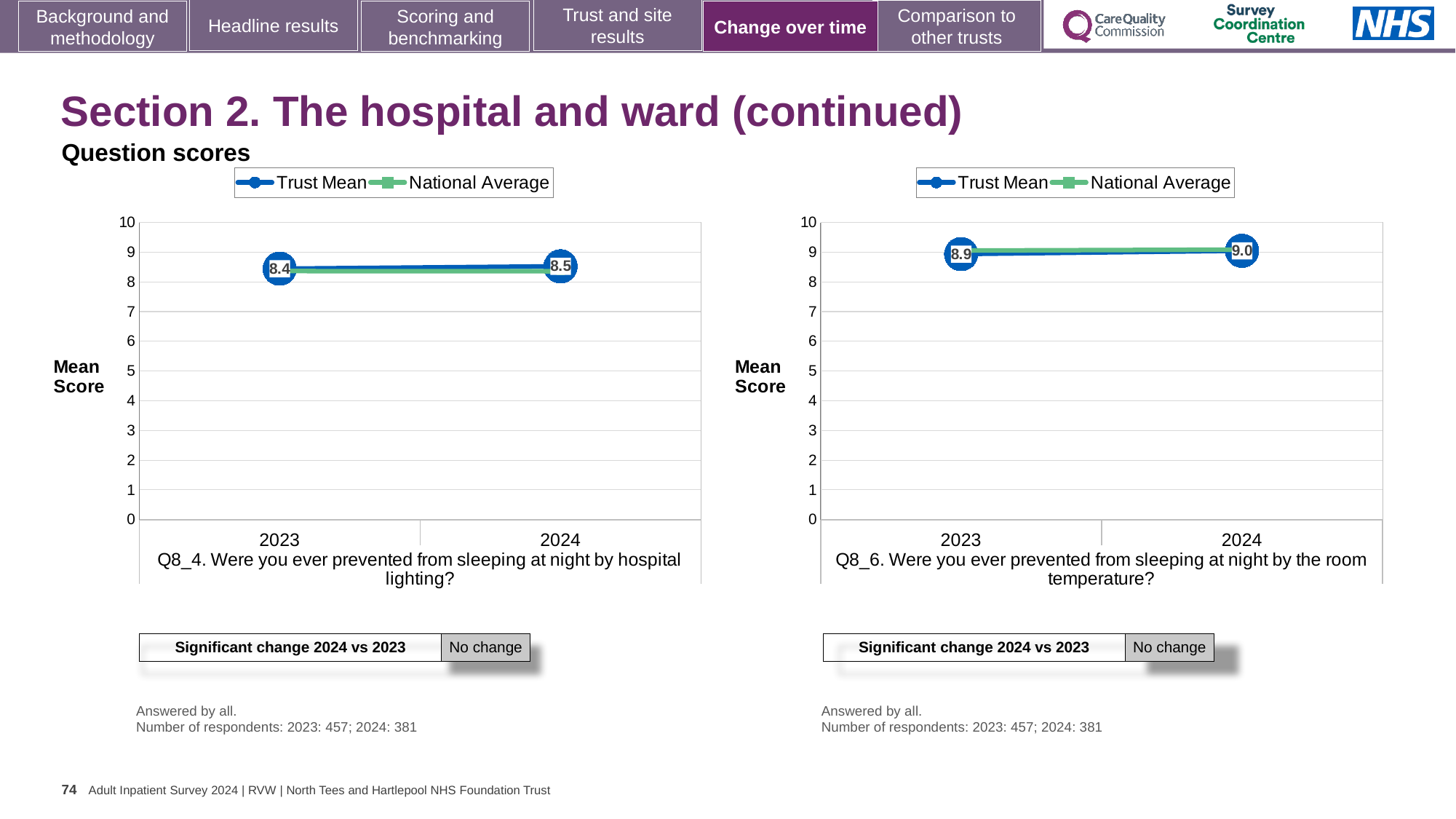
What kind of chart is the left chart (Q8_4, hospital lighting)? line chart On the left chart (Q8_4, hospital lighting), what is the Trust Mean score for 2024? 8.5 On the right chart (Q8_6, room temperature), what is the difference between the Trust Mean for 2024 and 2023? 0.1 On the right chart (Q8_6, room temperature), what is the Trust Mean score for 2024? 9.0 On the left chart (Q8_4, hospital lighting), what is the Trust Mean score for 2023? 8.4 How many series does the legend of the right chart (Q8_6, room temperature) list? 2 On the right chart (Q8_6, room temperature), what is the Trust Mean score for 2023? 8.9 On the left chart (Q8_4, hospital lighting), is the Trust Mean for 2023 greater or less than 5? greater On the left chart (Q8_4, hospital lighting), by how much did the Trust Mean change from 2023 to 2024? 0.1 How many years are plotted on the x axis of the left chart (Q8_4, hospital lighting)? 2 On the right chart (Q8_6, room temperature), does the Trust Mean rise or fall from 2023 to 2024? rise What does the box below the right chart (Q8_6, room temperature) say for 'Significant change 2024 vs 2023'? No change